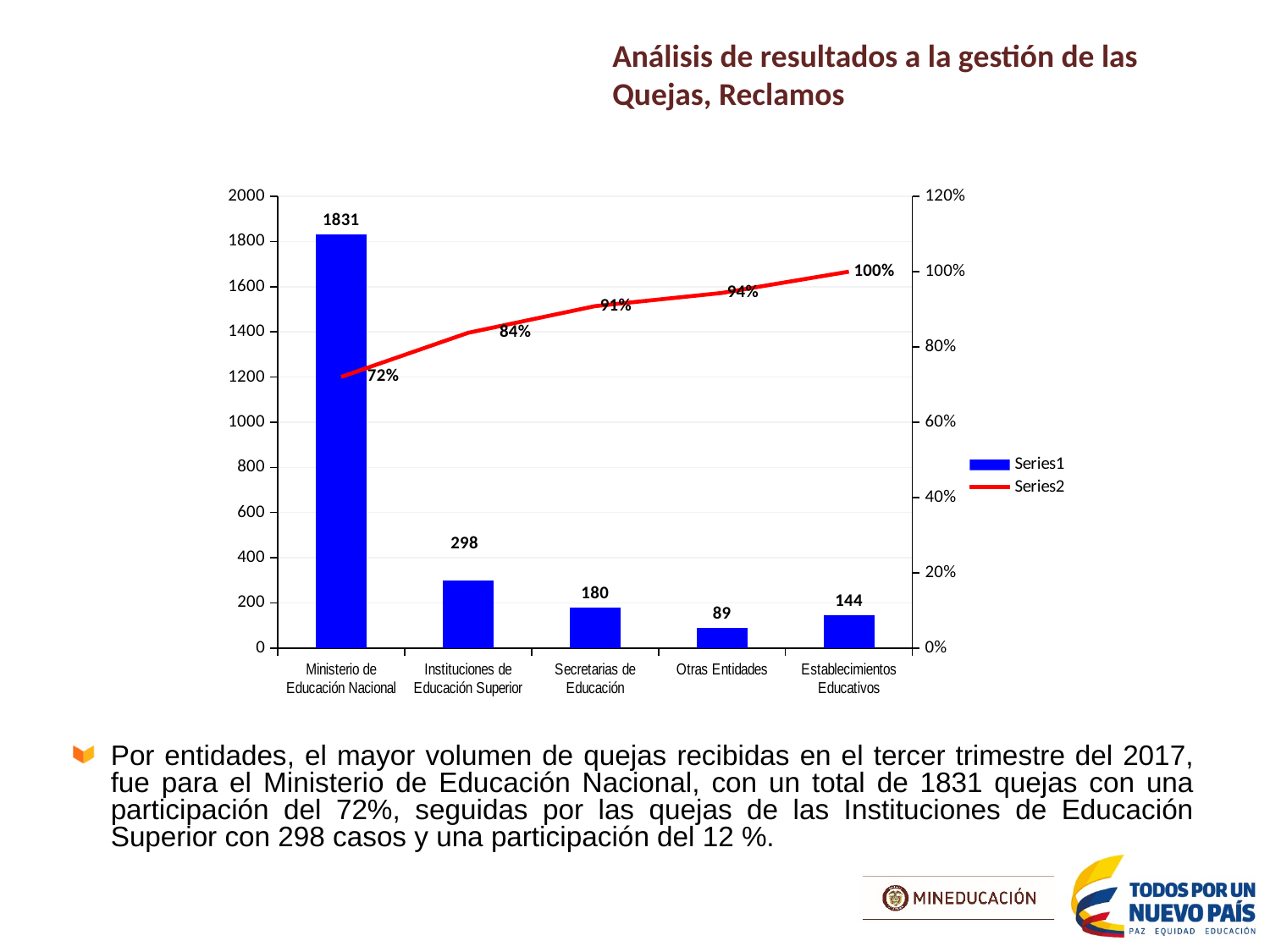
What is the difference between the bar values for Instituciones de Educación Superior and Secretarias de Educación? 118 What is the value of the bar for Ministerio de Educación Nacional? 1831 Which category has the highest bar? Ministerio de Educación Nacional How many categories are shown on the x axis? 5 Which category has the lowest bar? Otras Entidades Does the red line rise or fall from left to right across the categories? rise Which bar is larger, Establecimientos Educativos or Otras Entidades? Establecimientos Educativos What colour are the bars in the chart? Blue What cumulative percentage does the line show for Secretarias de Educación? 91% How many series does the legend list? 2 What is the value of the bar for Otras Entidades? 89 What cumulative percentage does the line show for Establecimientos Educativos? 100%